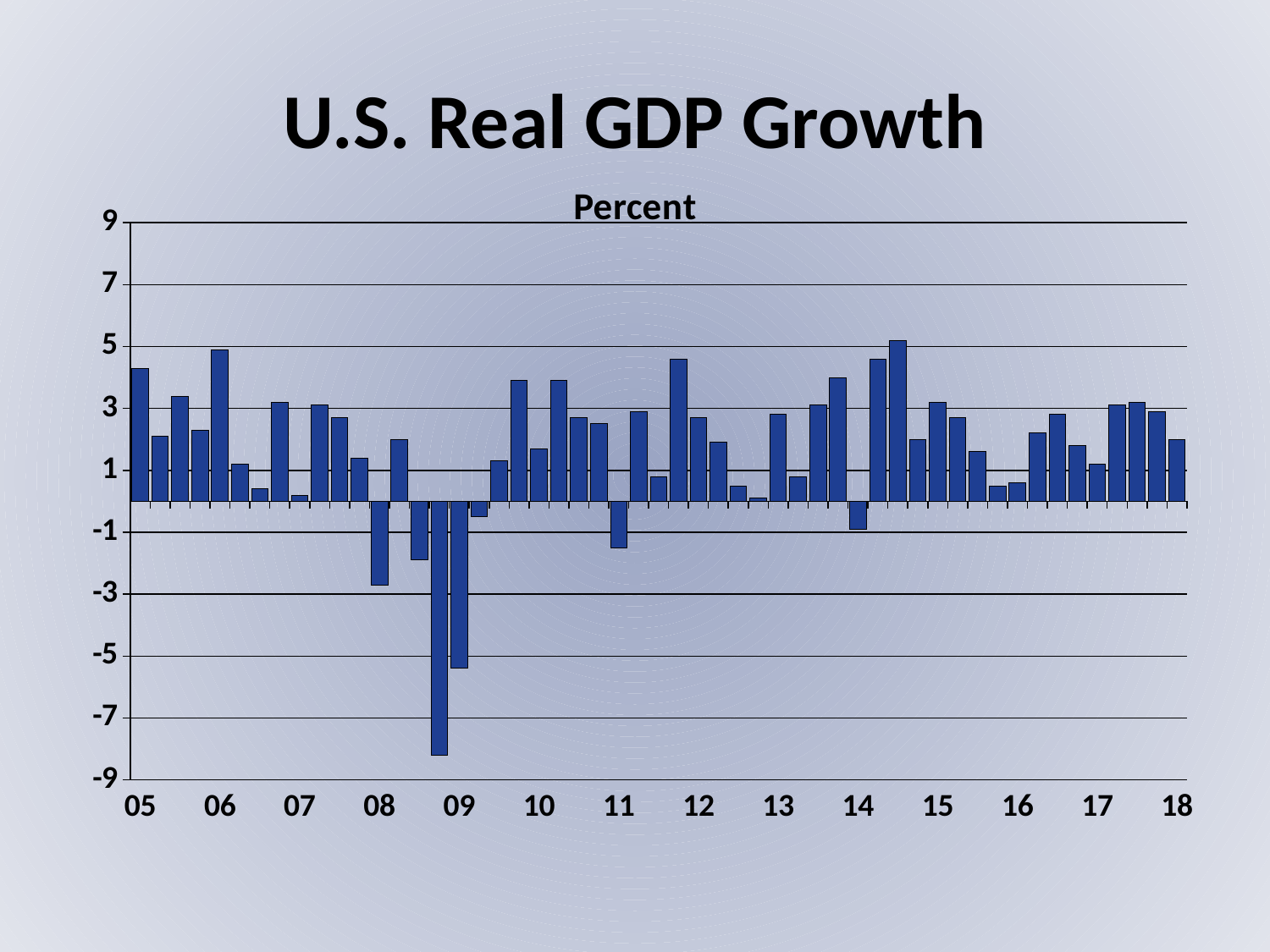
Is the highest bar on the chart greater or less than 3? greater What unit label is shown above the vertical axis? Percent Is the bar at the 18 label greater or less than 3? less What is the title of the chart? U.S. Real GDP Growth Is the bar at the 12 label greater or less than 3? less What kind of chart is shown on the slide? bar chart Which is larger, the bar at the 06 label or the bar at the 07 label? 06 How many year labels are shown along the x axis? 14 Between the 08 label and the 09 label, do the bars generally rise or fall? fall